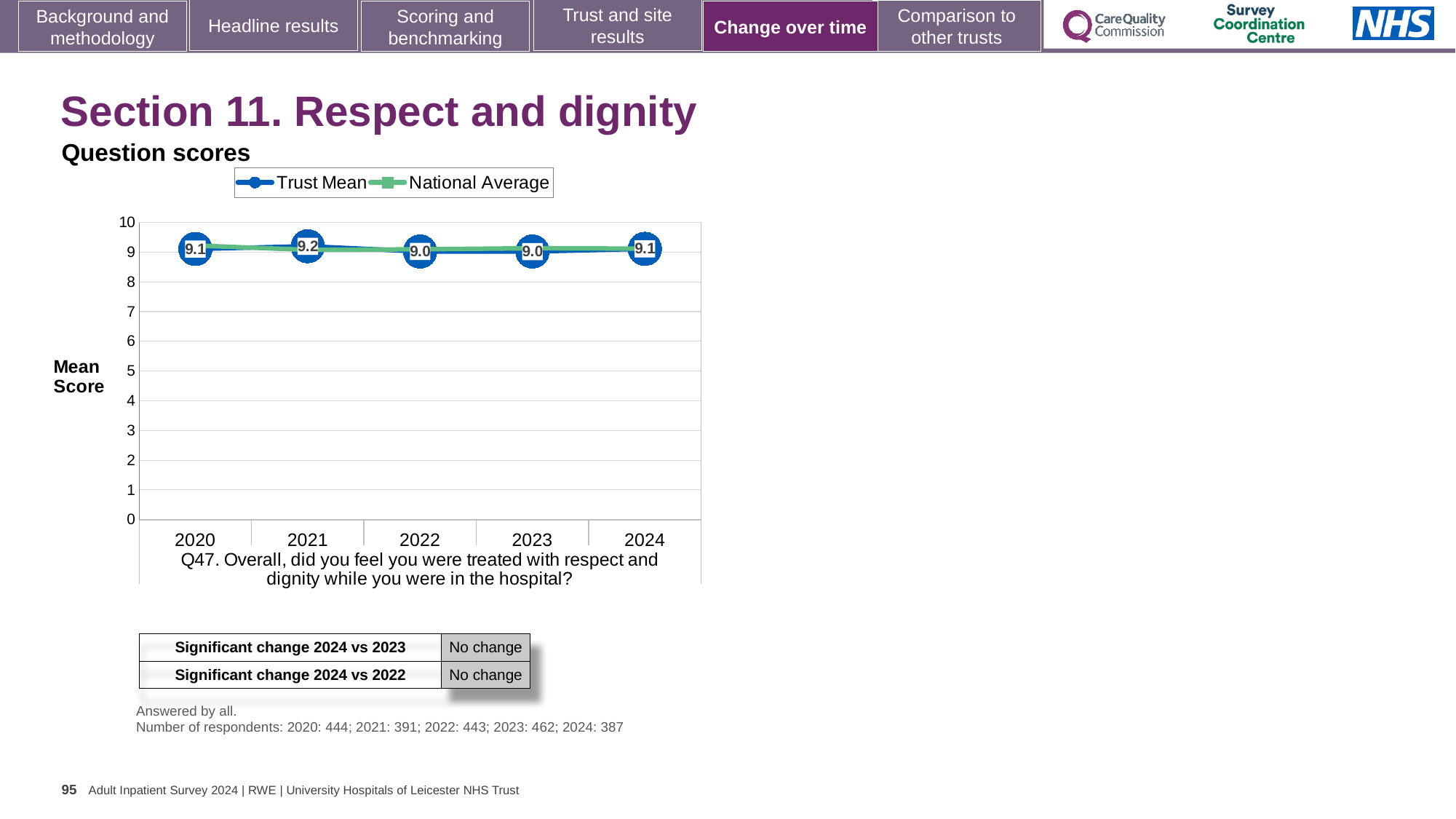
What is the Trust Mean score for 2021? 9.2 What kind of chart is shown? line chart Which year has the larger Trust Mean score, 2021 or 2023? 2021 Which series is shown in green in the legend? National Average What is the Trust Mean score for 2022? 9.0 In which year is the Trust Mean score highest? 2021 What is the difference between the Trust Mean scores for 2021 and 2022? 0.2 What is the label of the y axis? Mean Score How many series does the legend list? 2 Is the National Average value for 2024 greater or less than 5? greater How many years are plotted on the x axis? 5 What is the Trust Mean score for 2024? 9.1